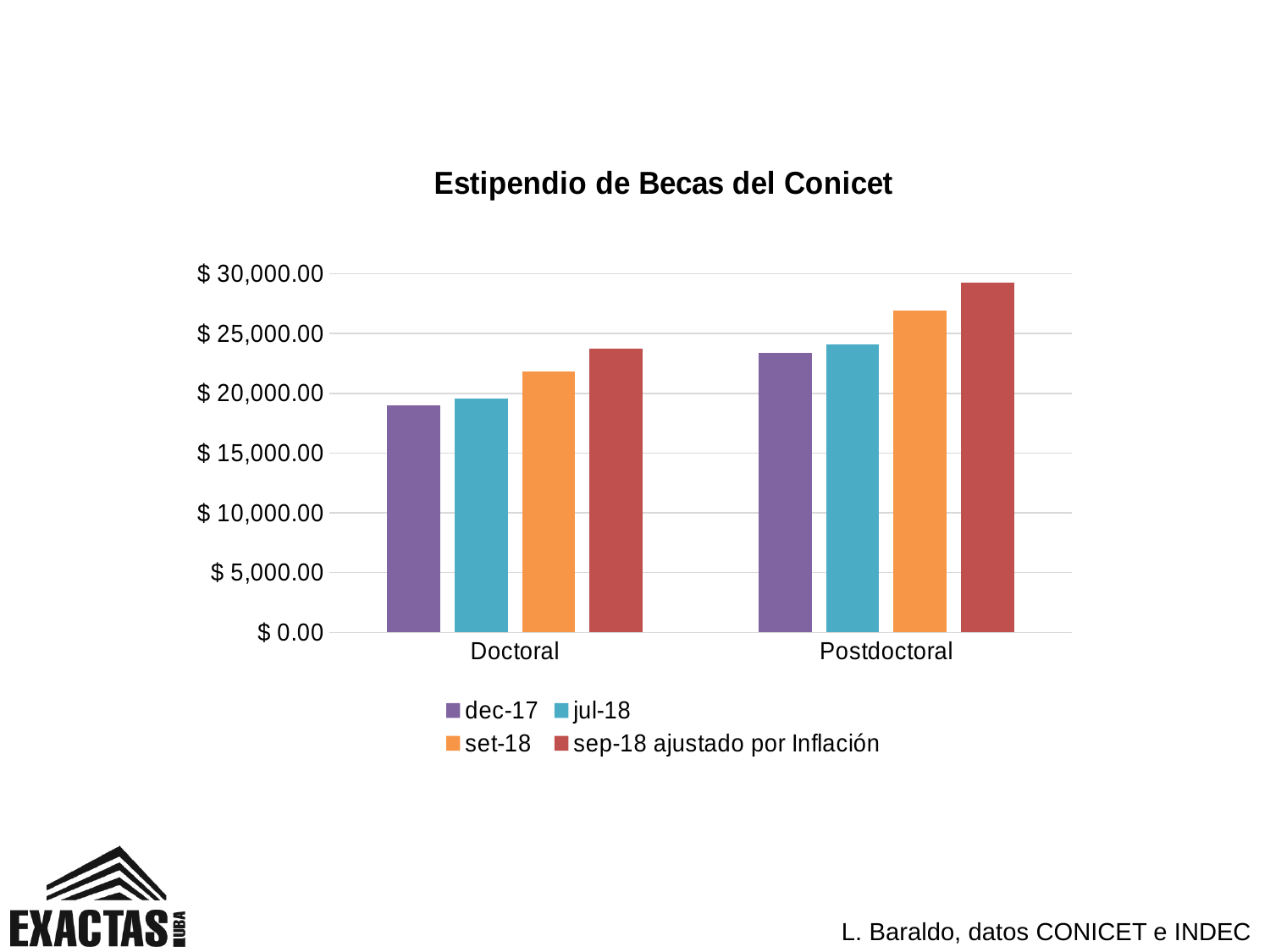
Is the dec-17 value for Doctoral greater or less than $ 20,000.00? less What kind of chart is shown on the slide? bar chart Is the dec-17 value for Postdoctoral greater or less than $ 25,000.00? less How many series does the legend list? 4 Is the set-18 value for Doctoral greater or less than $ 20,000.00? greater How many categories are shown on the x axis? 2 Which category and series has the highest bar in the chart? Postdoctoral, sep-18 ajustado por Inflación Within the Postdoctoral category, do the bars rise or fall from dec-17 to sep-18 ajustado por Inflación? rise What is the title of the chart? Estipendio de Becas del Conicet Which is larger: the set-18 value for Doctoral or the dec-17 value for Postdoctoral? dec-17 value for Postdoctoral Which category and series has the lowest bar in the chart? Doctoral, dec-17